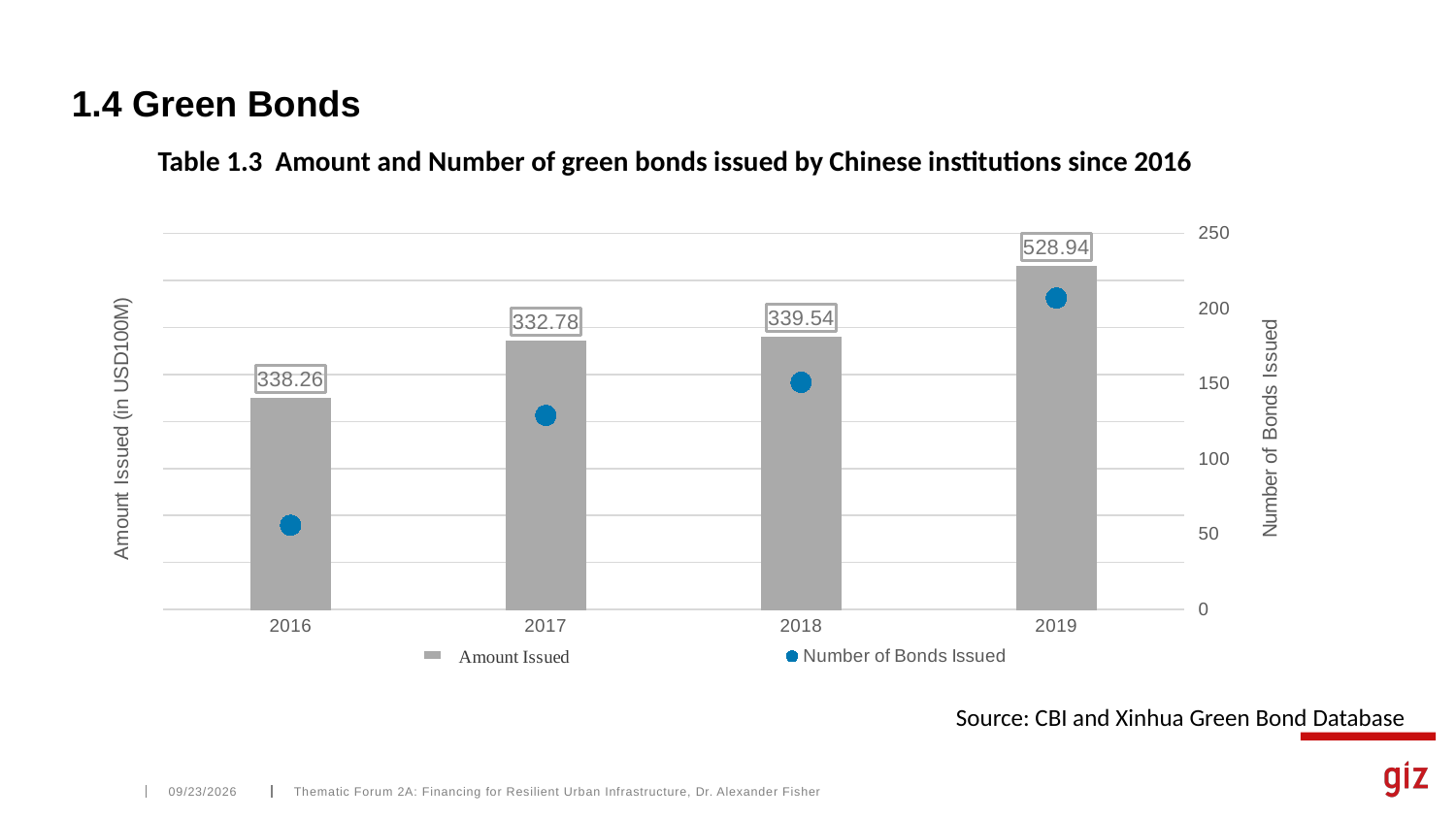
What is the Amount Issued for 2017? 332.78 What is the Amount Issued for 2018? 339.54 Is the Number of Bonds Issued for 2019 greater or less than 150? greater Does the Number of Bonds Issued rise or fall from 2016 to 2019? rise Is the Amount Issued larger in 2019 or in 2018? 2019 Which year has the highest Amount Issued? 2019 How many years are shown on the x axis? 4 Is the Number of Bonds Issued for 2016 greater or less than 100? less What is the Amount Issued for 2019? 528.94 How many series does the legend list? 2 What is the Amount Issued for 2016? 338.26 What is the difference in Amount Issued between 2019 and 2018? 189.40